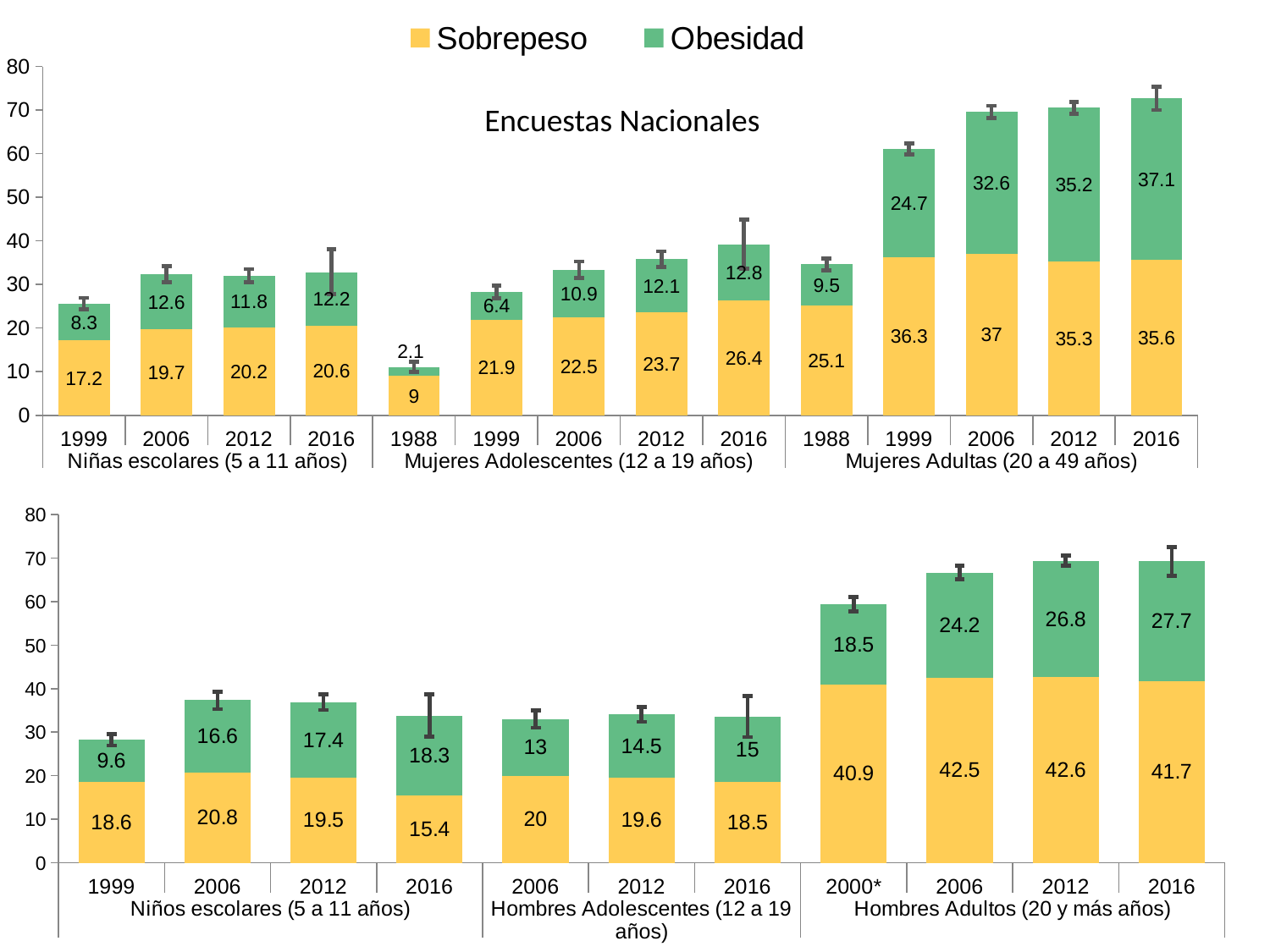
What kind of chart is the bottom chart? stacked bar chart In the bottom chart, what is the Sobrepeso value for Hombres Adultos (20 y más años) in 2000*? 40.9 In the top chart, what is the Sobrepeso value for Mujeres Adultas (20 a 49 años) in 2006? 37 In the top chart, does the Obesidad value for Mujeres Adolescentes (12 a 19 años) rise or fall from 1988 to 2016? rise How many series does the legend list? 2 In the top chart, what is the Obesidad value for Mujeres Adolescentes (12 a 19 años) in 1988? 2.1 In the bottom chart, which year has the lowest Sobrepeso value for Niños escolares (5 a 11 años)? 2016 In the top chart, which year has the highest Obesidad value for Mujeres Adultas (20 a 49 años)? 2016 In the bottom chart, what is the difference between the Obesidad values for Hombres Adultos (20 y más años) in 2016 and 2000*? 9.2 In the bottom chart, what is the Obesidad value for Niños escolares (5 a 11 años) in 2016? 18.3 In the bottom chart, which is larger for Hombres Adolescentes in 2016: Sobrepeso or Obesidad? Sobrepeso In the top chart, what is the total of the stacked bar for Mujeres Adultas (20 a 49 años) in 2016? 72.7